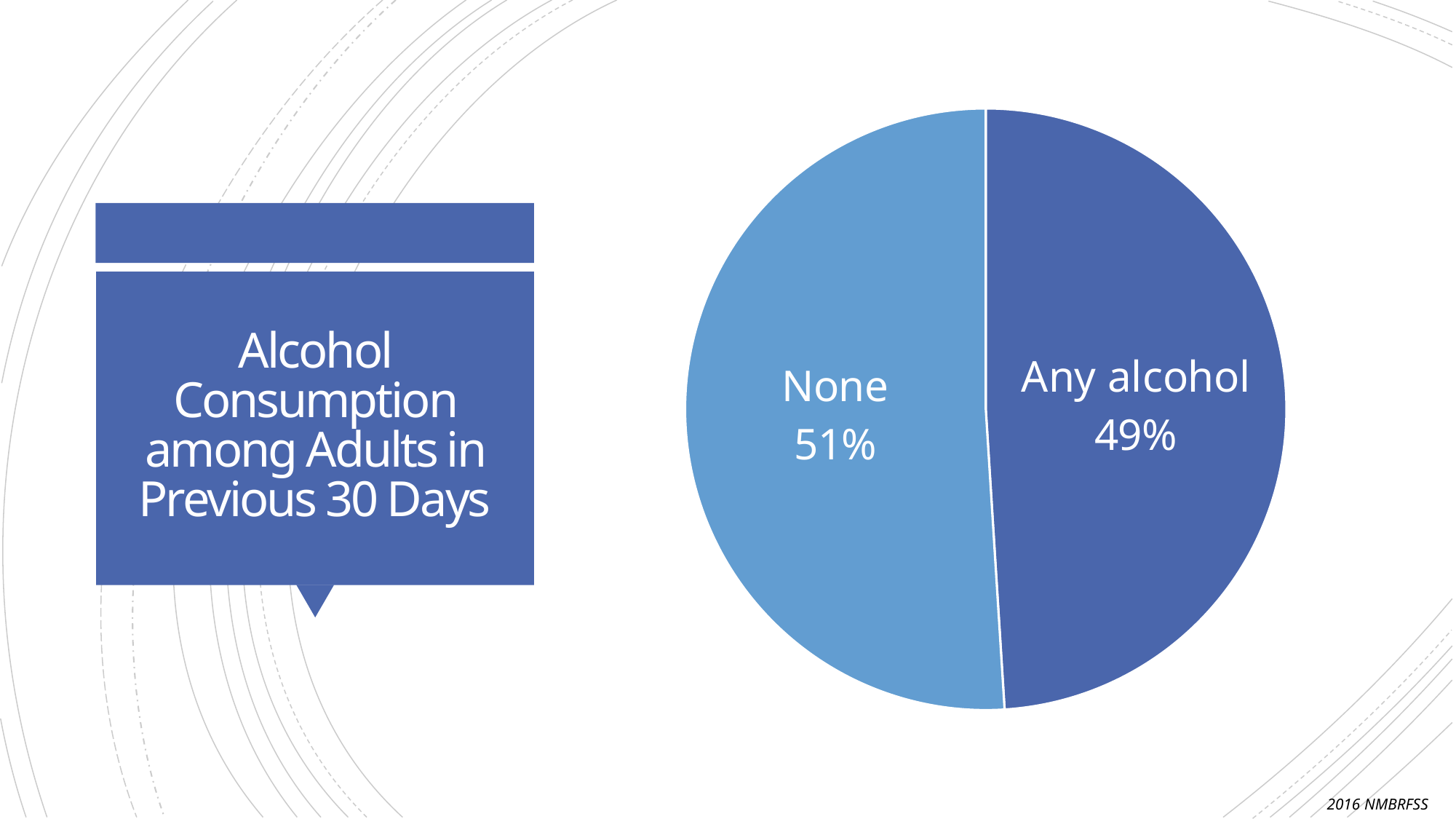
What is the difference in percentage points between the None slice and the Any alcohol slice? 2 What kind of chart is shown on the slide? Pie chart Which slice of the pie is larger, None or Any alcohol? None What data source is cited at the bottom right of the slide? 2016 NMBRFSS How many slices does the pie chart have? 2 What percentage of adults reported any alcohol consumption in the previous 30 days? 49% Is the value for Any alcohol greater or less than 50%? less Which category has the largest share of the pie? None What percentage of adults reported no alcohol consumption in the previous 30 days? 51% Which category has the smallest share of the pie? Any alcohol What is the title shown next to the pie chart? Alcohol Consumption among Adults in Previous 30 Days